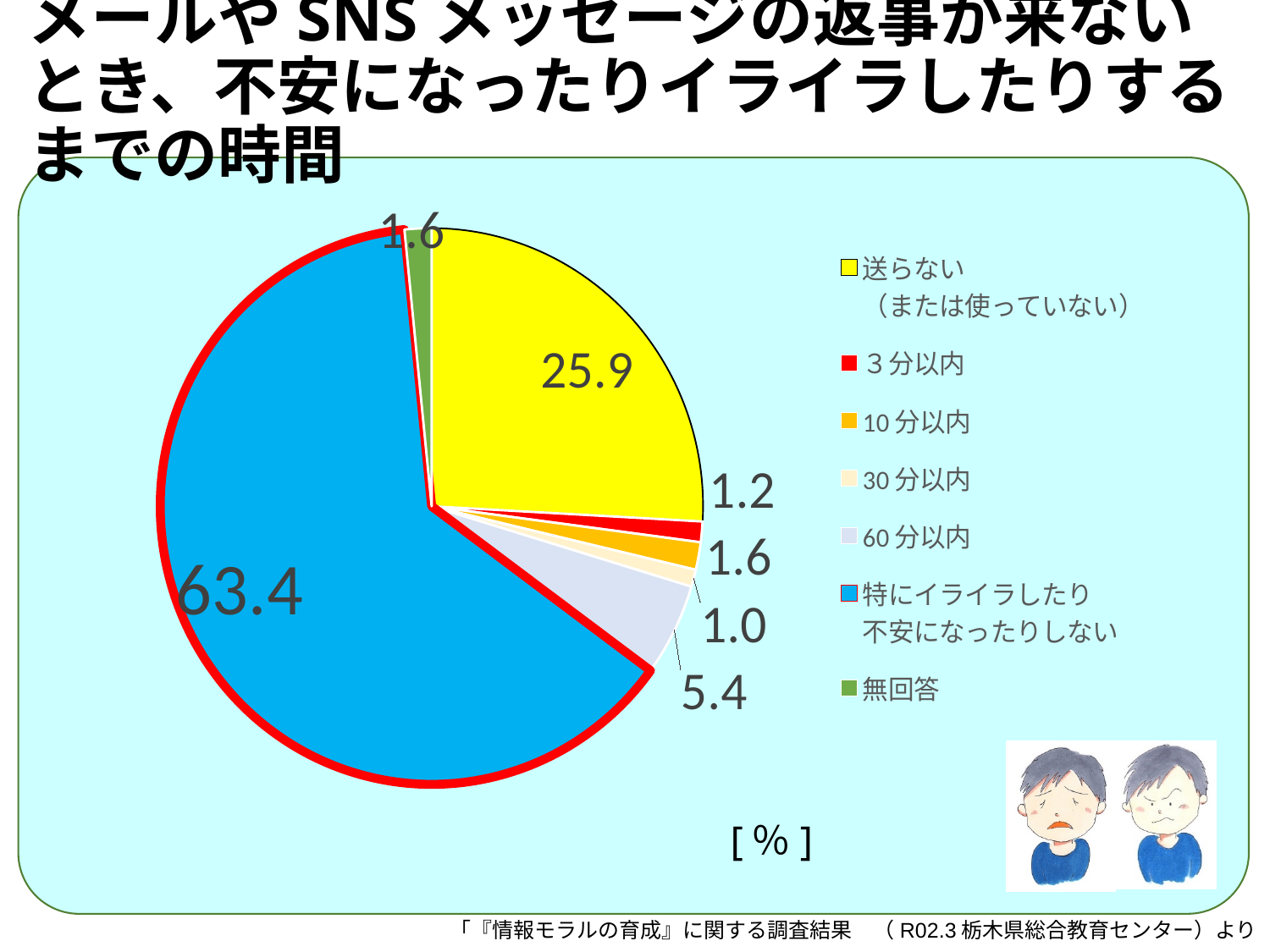
What is the value for 送らない（または使っていない）? 25.9 What is the value for 3分以内? 1.2 What is the value for 60分以内? 5.4 What is the difference between the values for 特にイライラしたり不安になったりしない and 送らない（または使っていない）? 37.5 What is the value for 特にイライラしたり不安になったりしない? 63.4 Which is larger, the value for 60分以内 or the value for 10分以内? 60分以内 What kind of chart is shown on the slide? pie chart What unit is shown below the pie chart? [％] How many categories does the pie chart have? 7 Which category has the largest slice? 特にイライラしたり不安になったりしない Which category has the smallest slice? 30分以内 What is the value for 無回答? 1.6